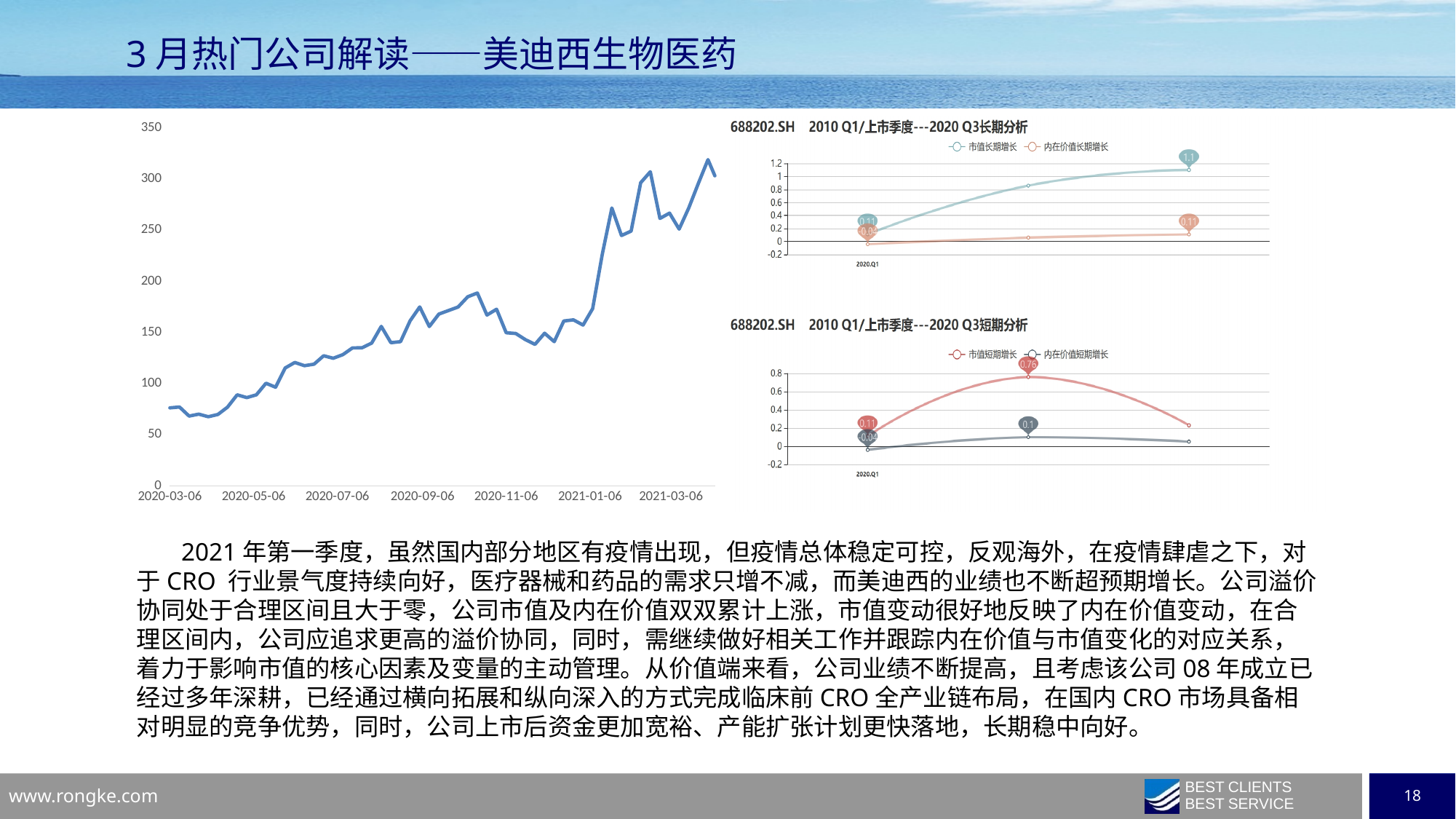
In the chart titled '688202.SH 2010 Q1/上市季度---2020 Q3长期分析', what is the labeled final value of 内在价值长期增长? 0.11 In the chart titled '688202.SH 2010 Q1/上市季度---2020 Q3短期分析', what is the labeled peak value of 市值短期增长? 0.76 What kind of chart is the large chart on the left of the slide? line chart In the large line chart on the left, do the values generally rise or fall from 2020-03-06 to 2021-03-06? rise In the chart titled '688202.SH 2010 Q1/上市季度---2020 Q3短期分析', what is the labeled value of 内在价值短期增长 at the middle point? 0.1 How many date labels are shown on the x axis of the large line chart on the left? 7 In the chart titled '688202.SH 2010 Q1/上市季度---2020 Q3短期分析', what are the two legend entries? 市值短期增长 and 内在价值短期增长 In the chart titled '688202.SH 2010 Q1/上市季度---2020 Q3长期分析', which series ends at the higher value, 市值长期增长 or 内在价值长期增长? 市值长期增长 In the large line chart on the left, is the value at 2021-03-06 greater or less than 250? greater In the chart titled '688202.SH 2010 Q1/上市季度---2020 Q3长期分析', how many series does the legend list? 2 In the large line chart on the left, is the value at 2020-03-06 greater or less than 100? less In the chart titled '688202.SH 2010 Q1/上市季度---2020 Q3长期分析', what is the labeled final value of 市值长期增长? 1.1